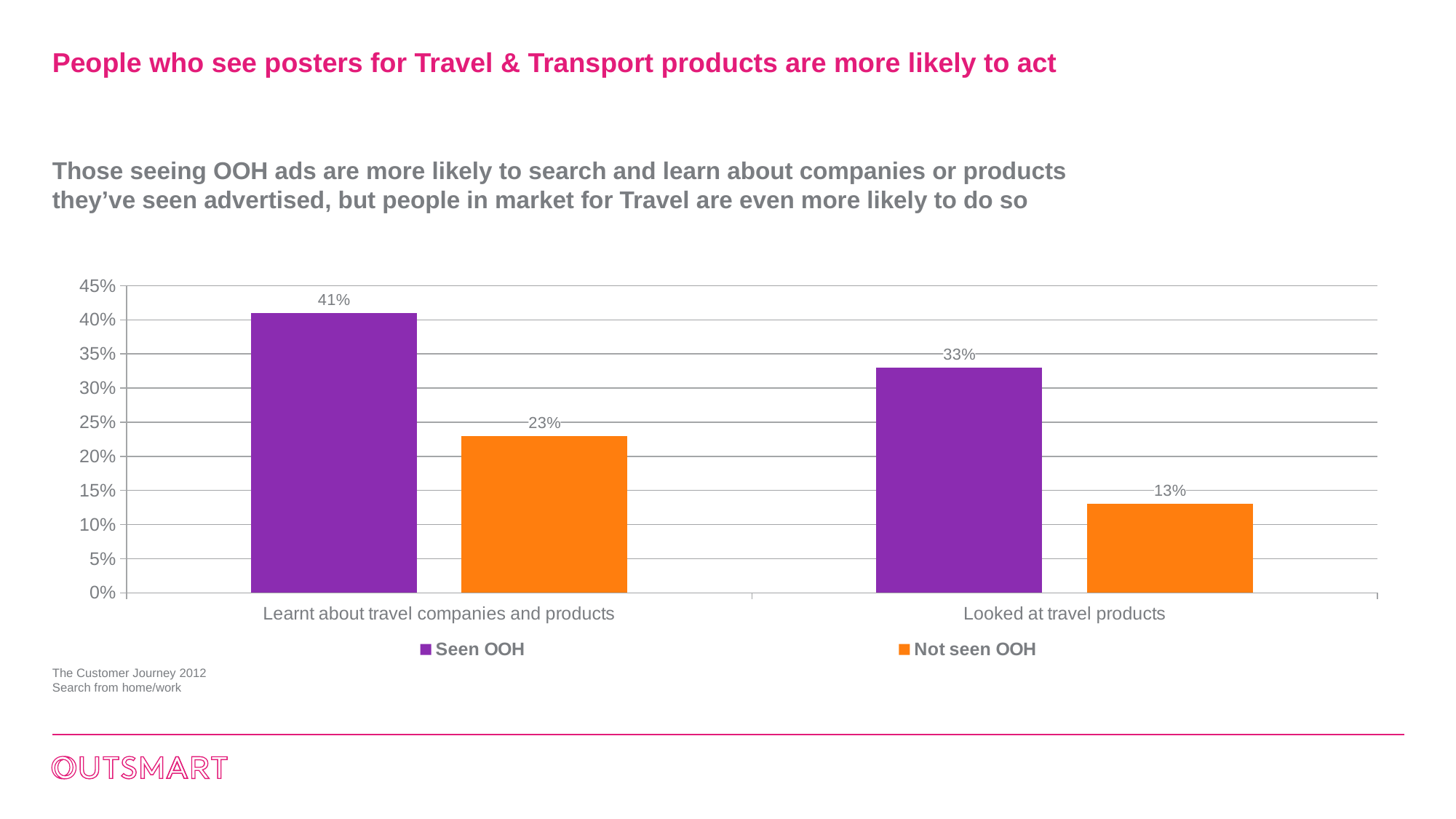
Which is larger for 'Looked at travel products': Seen OOH or Not seen OOH? Seen OOH Which bar has the lowest value on the chart? Not seen OOH, Looked at travel products What is the value for Not seen OOH in the 'Learnt about travel companies and products' category? 23% What is the difference between Seen OOH and Not seen OOH for 'Learnt about travel companies and products'? 18% What is the difference between Seen OOH and Not seen OOH for 'Looked at travel products'? 20% What is the value for Seen OOH in the 'Looked at travel products' category? 33% What is the value for Seen OOH in the 'Learnt about travel companies and products' category? 41% Which bar has the highest value on the chart? Seen OOH, Learnt about travel companies and products What is the value for Not seen OOH in the 'Looked at travel products' category? 13% How many categories are shown on the x axis? 2 What kind of chart is shown on the slide? Bar chart How many series does the legend list? 2